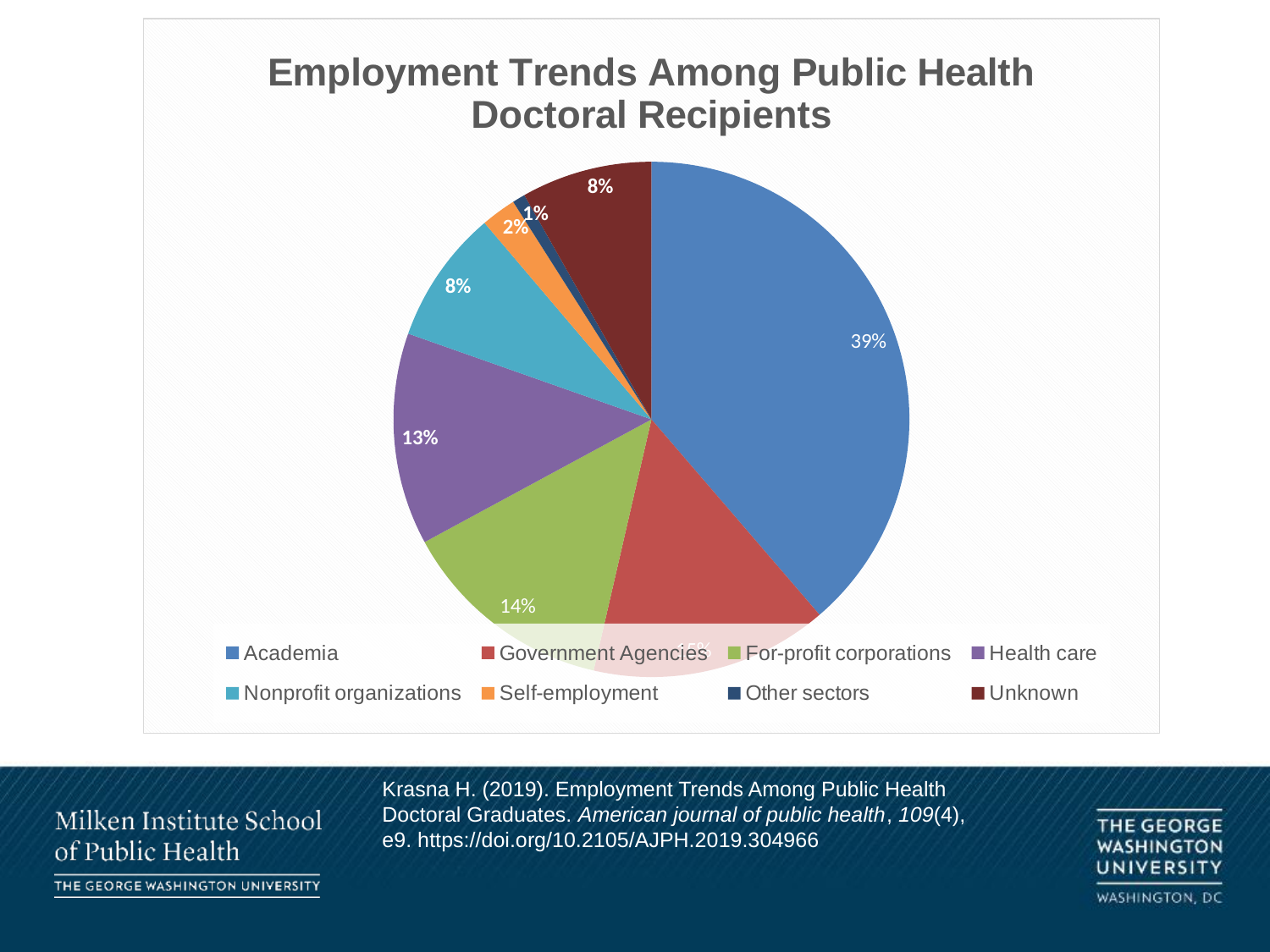
What percentage of the pie is For-profit corporations? 14% Which employment sector has the smallest share of the pie? Other sectors What percentage of public health doctoral recipients are employed in Academia? 39% What is the title of the chart? Employment Trends Among Public Health Doctoral Recipients What percentage is shown for Other sectors? 1% What is the difference in percentage points between Academia and Health care? 26 How many sectors does the legend list? 8 What percentage is shown for Self-employment? 2% What share of the pie does Health care represent? 13% Which employment sector has the largest share of the pie? Academia What type of chart is shown on the slide? Pie chart Which is larger, the share for Academia or the share for Government Agencies? Academia